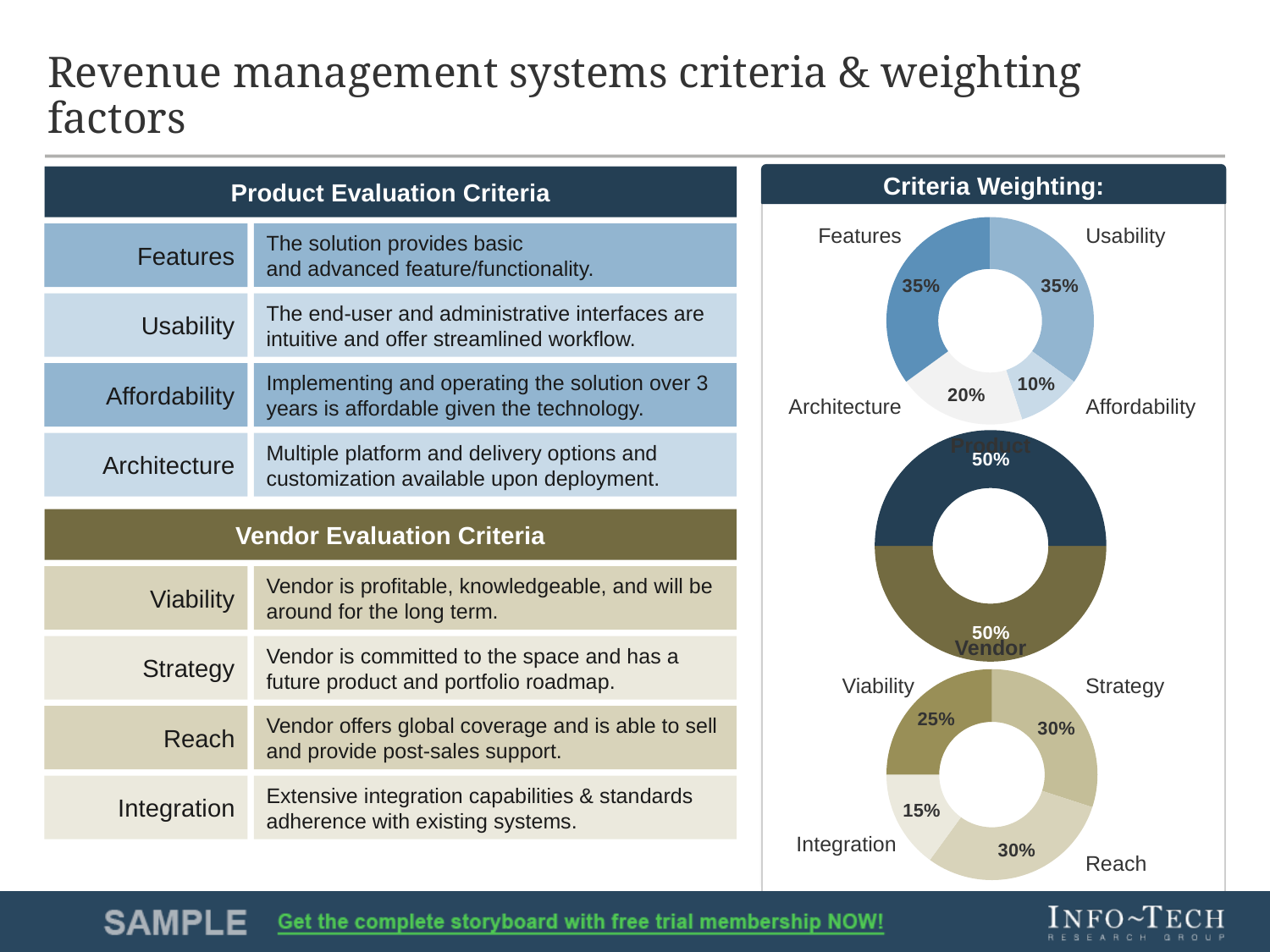
In the bottom donut chart, which category has the lowest weighting? Integration In the top donut chart, what is the difference between the Architecture and Affordability weightings? 10% In the top donut chart, what is the weighting for Affordability? 10% In the middle donut chart, what is the weighting for Vendor? 50% In the bottom donut chart, which is larger, Strategy or Viability? Strategy In the bottom donut chart, what is the weighting for Integration? 15% In the top donut chart, how many categories are shown? 4 In the bottom donut chart, what is the weighting for Viability? 25% In the top donut chart, which category has the lowest weighting? Affordability In the top donut chart, what is the weighting for Features? 35% What kind of chart is used in the Criteria Weighting panel? Donut chart In the middle donut chart, how many slices are there? 2